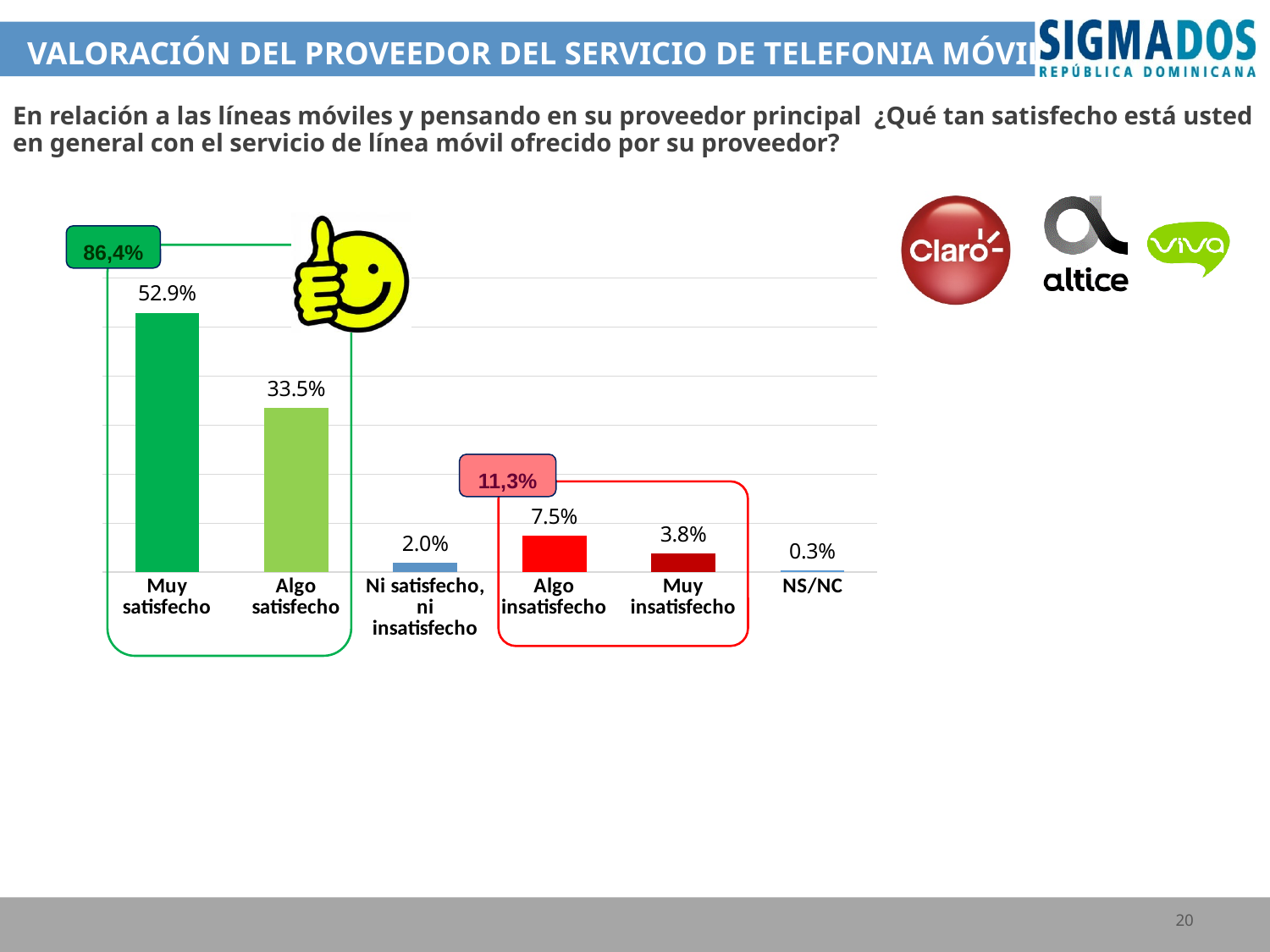
What is the value for Ni satisfecho, ni insatisfecho? 2.0% Which is larger, Algo insatisfecho or Muy insatisfecho? Algo insatisfecho What is the value for Algo satisfecho? 33.5% What is the value for Muy satisfecho? 52.9% What is the value for NS/NC? 0.3% Which category has the lowest value? NS/NC Which category has the highest value? Muy satisfecho What combined percentage is shown in the green callout above the satisfied bars? 86,4% What is the difference between Muy satisfecho and Algo satisfecho? 19.4% How many categories are shown on the x axis? 6 What is the value for Algo insatisfecho? 7.5% What kind of chart is shown on the slide? Bar chart